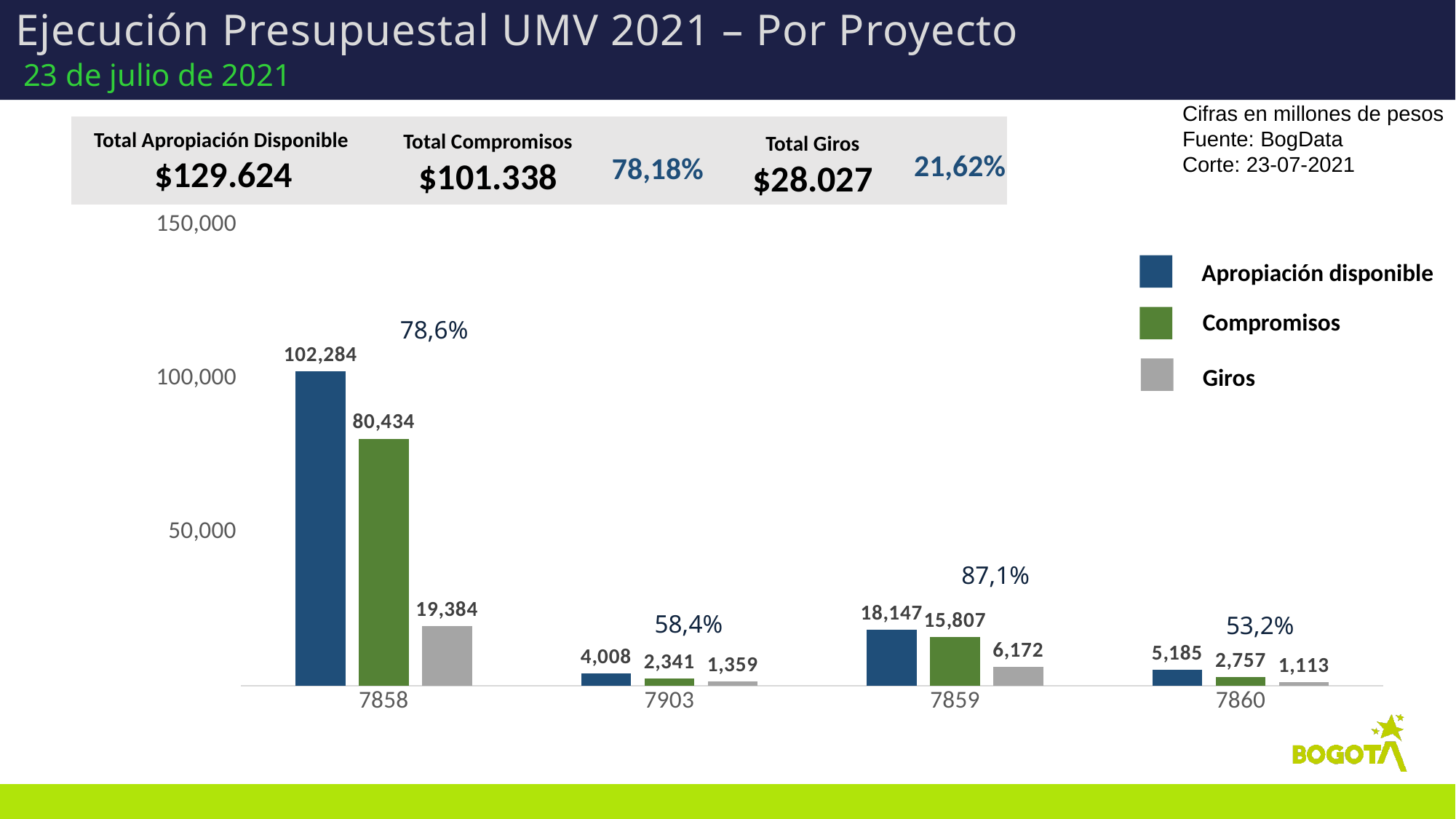
Which is larger: the Compromisos value for project 7903 or for project 7860? 7860 How many series does the legend list? 3 Is the Apropiación disponible value for project 7858 greater or less than 100,000? greater What is the Compromisos value for project 7860? 2,757 Which project has the lowest Giros value? 7860 How many projects are shown on the x axis? 4 What is the Giros value for project 7859? 6,172 Which project has the highest Apropiación disponible value? 7858 What percentage is shown above the bars for project 7859? 87,1% What is the difference between Apropiación disponible and Compromisos for project 7858? 21,850 What kind of chart is shown on the slide? bar chart What is the Apropiación disponible value for project 7858? 102,284